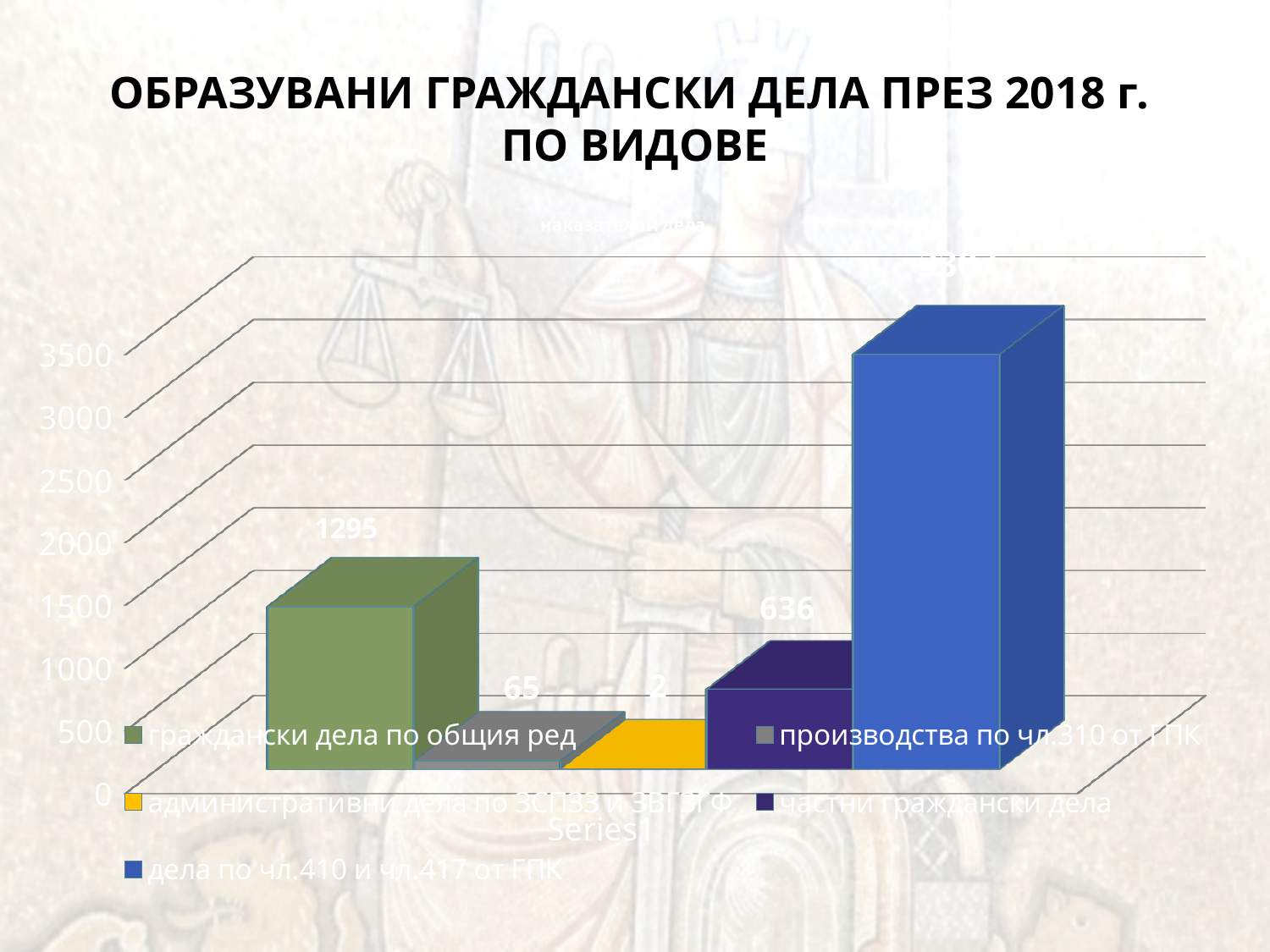
Which is larger: граждански дела по общия ред or частни граждански дела? граждански дела по общия ред Which category has the highest value? дела по чл.410 и чл.417 от ГПК What kind of chart is shown on the slide? bar chart How many series does the legend list? 5 What is the value for административни дела по ЗСПЗЗ и ЗВГЗГФ? 2 What is the value for производства по чл.310 от ГПК? 65 What is the difference between частни граждански дела and производства по чл.310 от ГПК? 571 What is the value for частни граждански дела? 636 What is the difference between граждански дела по общия ред and частни граждански дела? 659 Is the value for дела по чл.410 и чл.417 от ГПК greater or less than 2500? greater What is the value for граждански дела по общия ред? 1295 Which category has the lowest value? административни дела по ЗСПЗЗ и ЗВГЗГФ